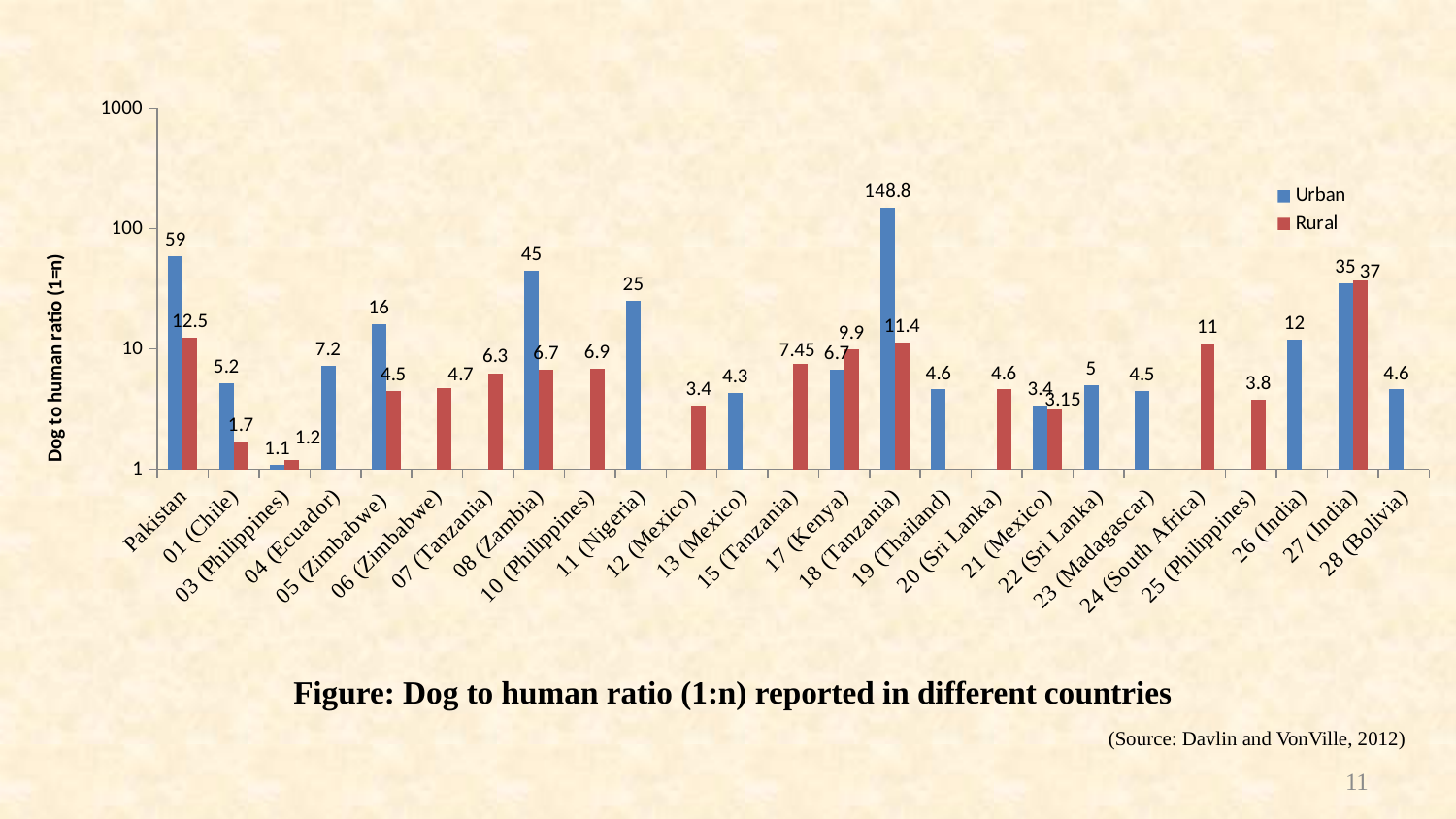
Which category has the lowest Urban value? 03 (Philippines) What is the Urban value for 08 (Zambia)? 45 For 27 (India), which is larger, the Urban value or the Rural value? Rural How many series does the legend list? 2 What is the label of the vertical axis? Dog to human ratio (1=n) Which colour represents the Rural series in the legend? Red What kind of chart is shown on the slide? Bar chart What is the difference between the Urban and Rural values for Pakistan? 46.5 Which category has the highest Urban value? 18 (Tanzania) What is the Urban value for 18 (Tanzania)? 148.8 What is the Rural value for Pakistan? 12.5 What is the Rural value for 24 (South Africa)? 11